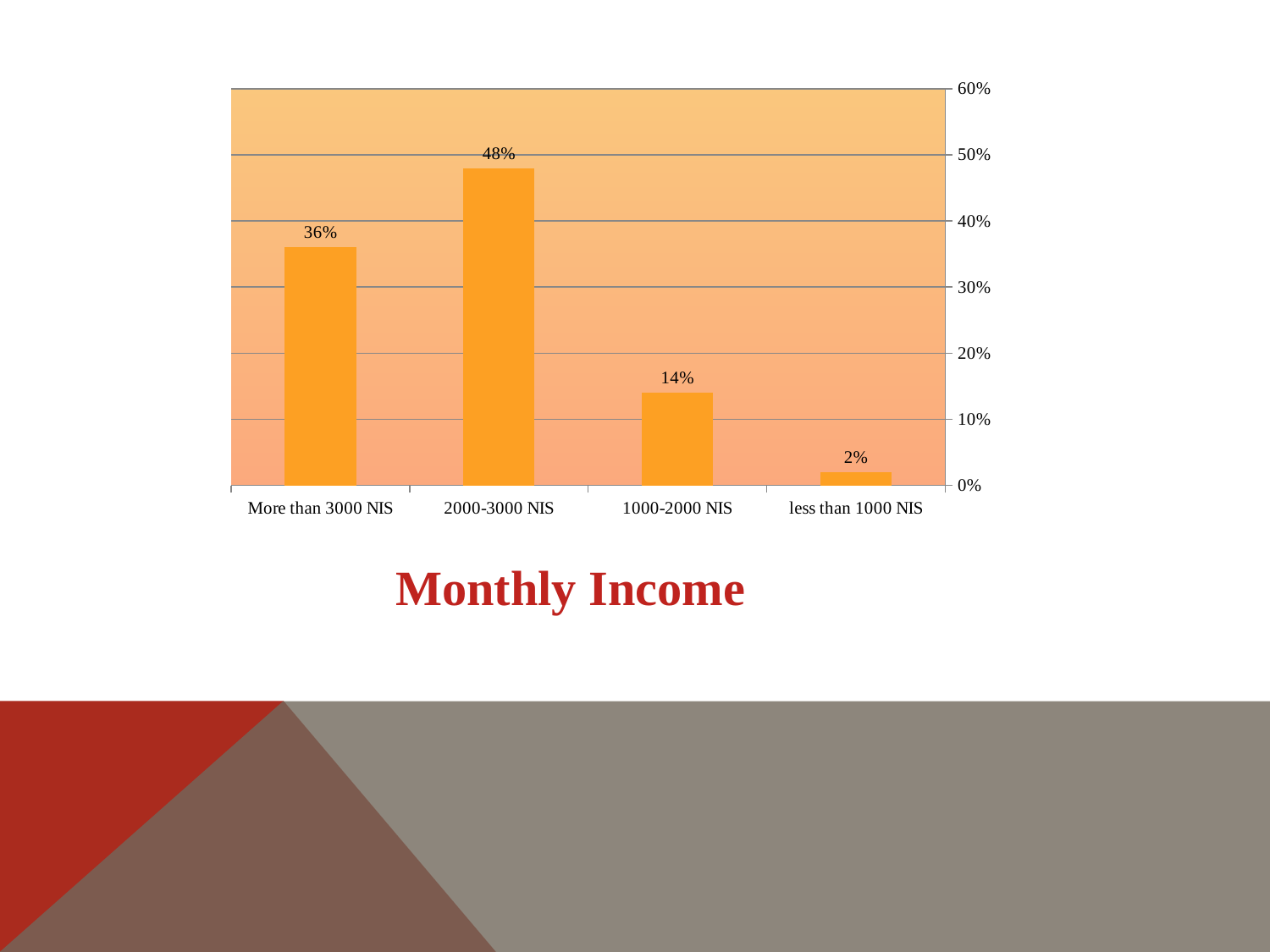
What is the value for the 2000-3000 NIS category? 48% What is the value for the less than 1000 NIS category? 2% What is the value for the More than 3000 NIS category? 36% Which category has the lowest value? less than 1000 NIS Which is larger, the value for 1000-2000 NIS or the value for less than 1000 NIS? 1000-2000 NIS Is the value for More than 3000 NIS greater or less than 30%? greater What kind of chart is shown on the slide? bar chart Which category has the highest value? 2000-3000 NIS How many categories are shown on the x axis? 4 What is the title shown below the chart? Monthly Income What is the value for the 1000-2000 NIS category? 14% What is the difference between the values for 2000-3000 NIS and More than 3000 NIS? 12%